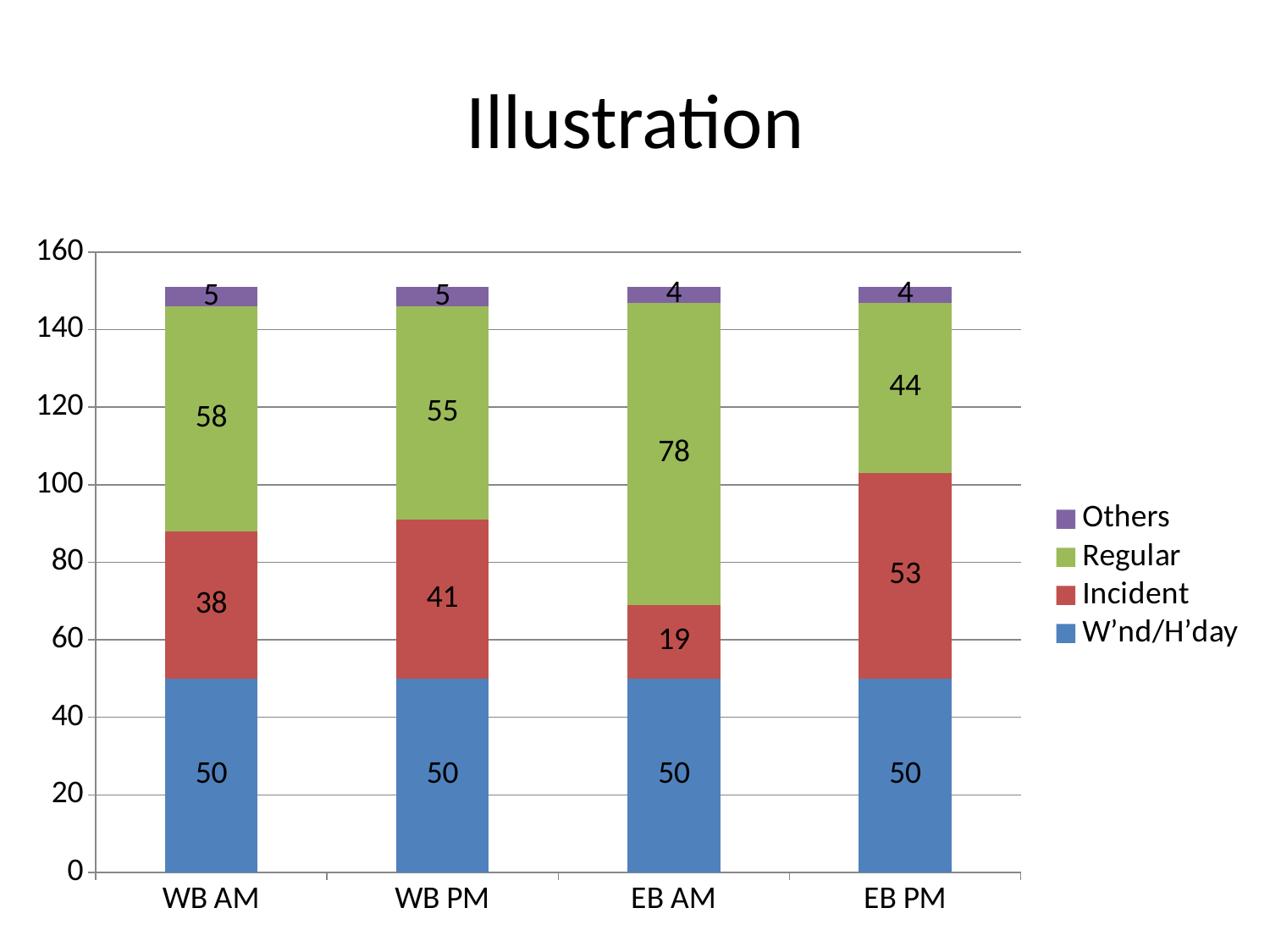
Which is larger, the Regular value for WB AM or for WB PM? WB AM What kind of chart is shown on the slide? Stacked bar chart What is the Incident value for WB PM? 41 What is the Regular value for EB AM? 78 Which category has the highest Regular value? EB AM Which category has the lowest Incident value? EB AM What is the W'nd/H'day value for WB AM? 50 What is the difference between the Incident values for EB PM and EB AM? 34 What is the Others value for EB PM? 4 How many categories are shown on the x axis? 4 How many series does the legend list? 4 What is the total of the stacked bar for EB PM? 151